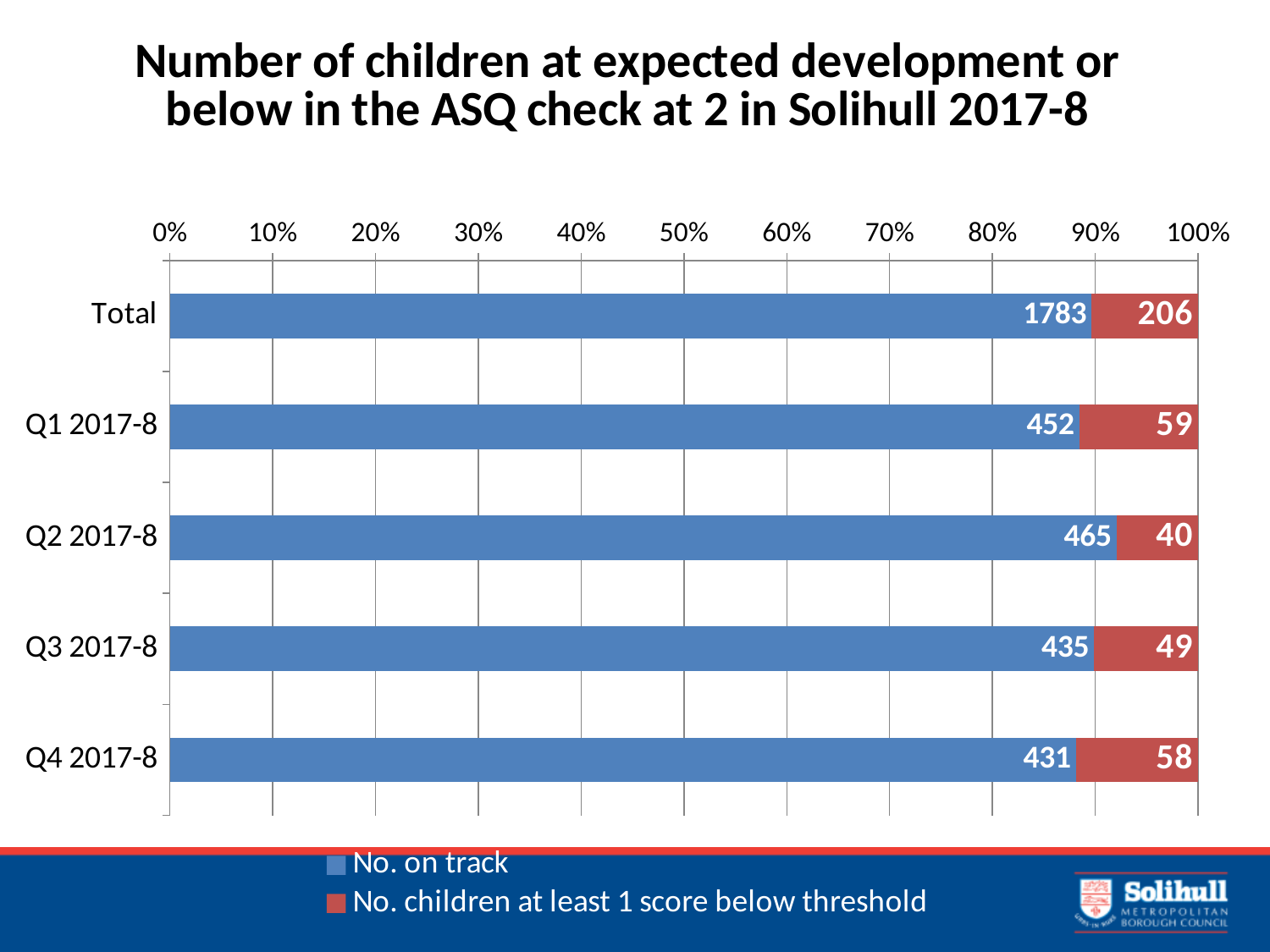
Among the four quarters, which has the highest number of children with at least 1 score below threshold? Q1 2017-8 How many series does the legend list? 2 What kind of chart is shown on the slide? Stacked bar chart What is the number on track for the Total bar? 1783 What is the total number of children in the Q1 2017-8 bar (on track plus below threshold)? 511 Among the four quarters, which has the lowest number of children with at least 1 score below threshold? Q2 2017-8 What is the difference between the number on track in Q2 2017-8 and Q4 2017-8? 34 How many children had at least 1 score below threshold in Q4 2017-8? 58 Is the share of the Q2 2017-8 bar taken by 'No. on track' greater or less than 90%? greater Which is larger: the number on track in Q1 2017-8 or in Q3 2017-8? Q1 2017-8 What is the number on track for Q2 2017-8? 465 How many categories are shown on the vertical axis? 5